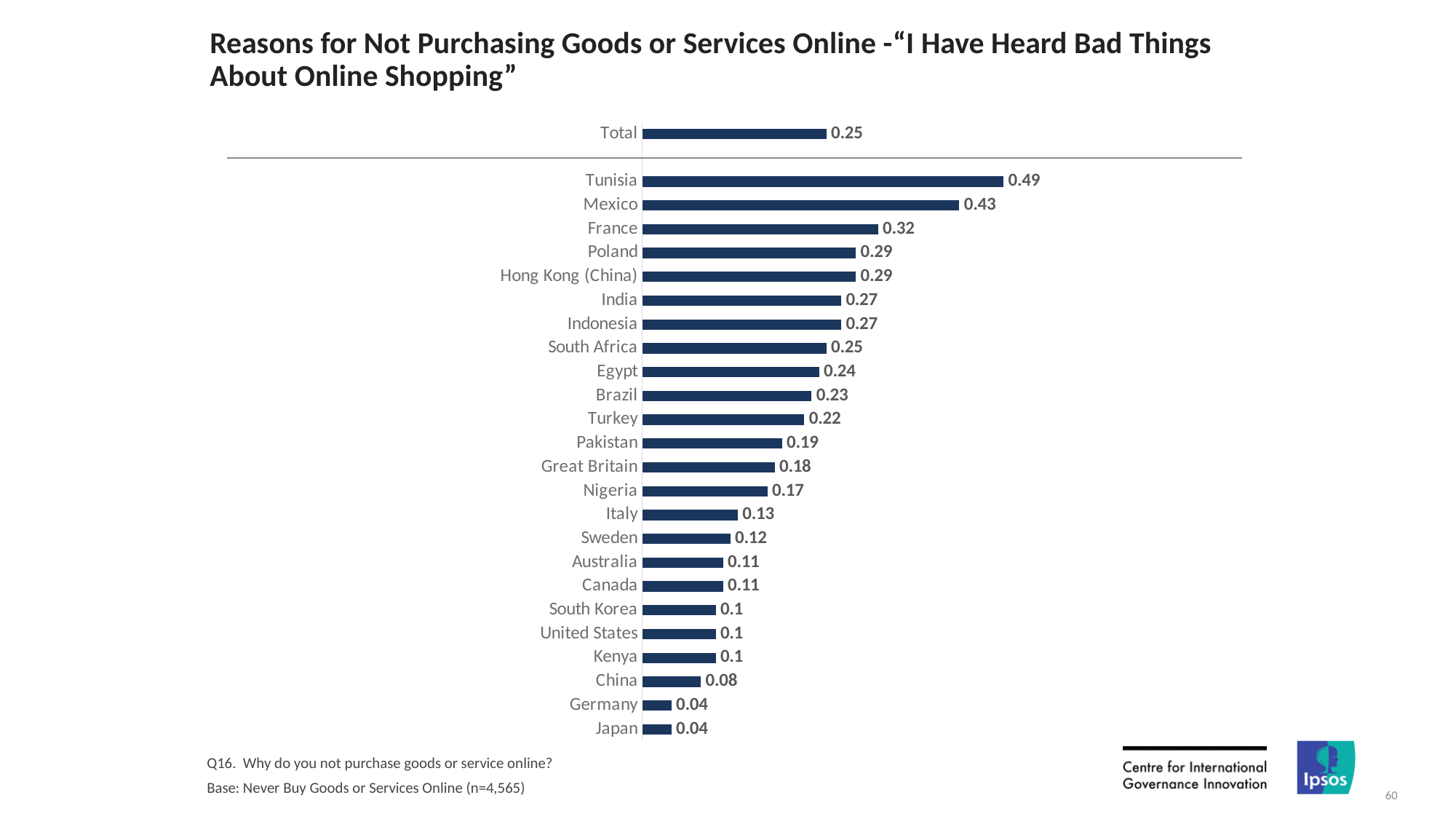
What is the value for China? 0.08 What is the difference between the values for Tunisia and Mexico? 0.06 What is the value for Great Britain? 0.18 Which has a larger value, Egypt or Pakistan? Egypt How many countries are shown in the chart, excluding the Total bar? 23 What is the value for Tunisia? 0.49 What is the difference between the values for France and Italy? 0.19 Which country has the highest value? Tunisia What is the value for Total? 0.25 What kind of chart is shown on the slide? Bar chart Which has a larger value, Sweden or Nigeria? Nigeria What is the base sample size (n) stated below the chart? 4,565